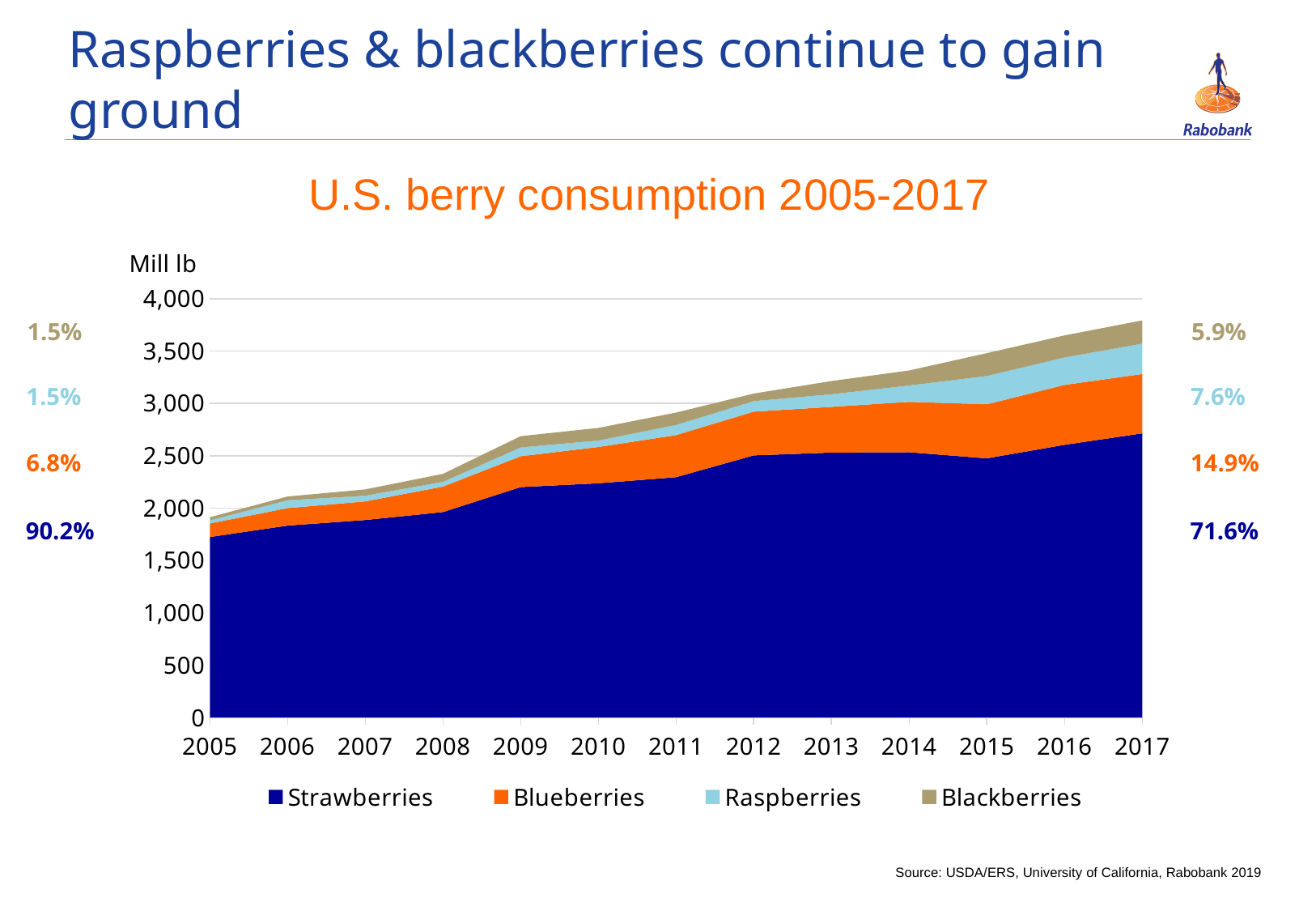
Does total U.S. berry consumption rise or fall from 2005 to 2017? Rise What is the unit shown on the y axis? Mill lb By how many percentage points did the strawberry share fall between 2005 (90.2%) and 2017 (71.6%)? 18.6 percentage points Which berry accounts for the largest share of consumption in 2017? Strawberries What share of U.S. berry consumption did blueberries have in 2017? 14.9% How many years are shown on the x axis? 13 Which berry accounts for the smallest share of consumption in 2017? Blackberries How many series does the legend list? 4 Is total berry consumption in 2017 greater or less than 3,500 Mill lb? greater Is total berry consumption in 2005 greater or less than 2,000 Mill lb? less What kind of chart is shown on the slide? Stacked area chart What share of U.S. berry consumption did strawberries have in 2005? 90.2%